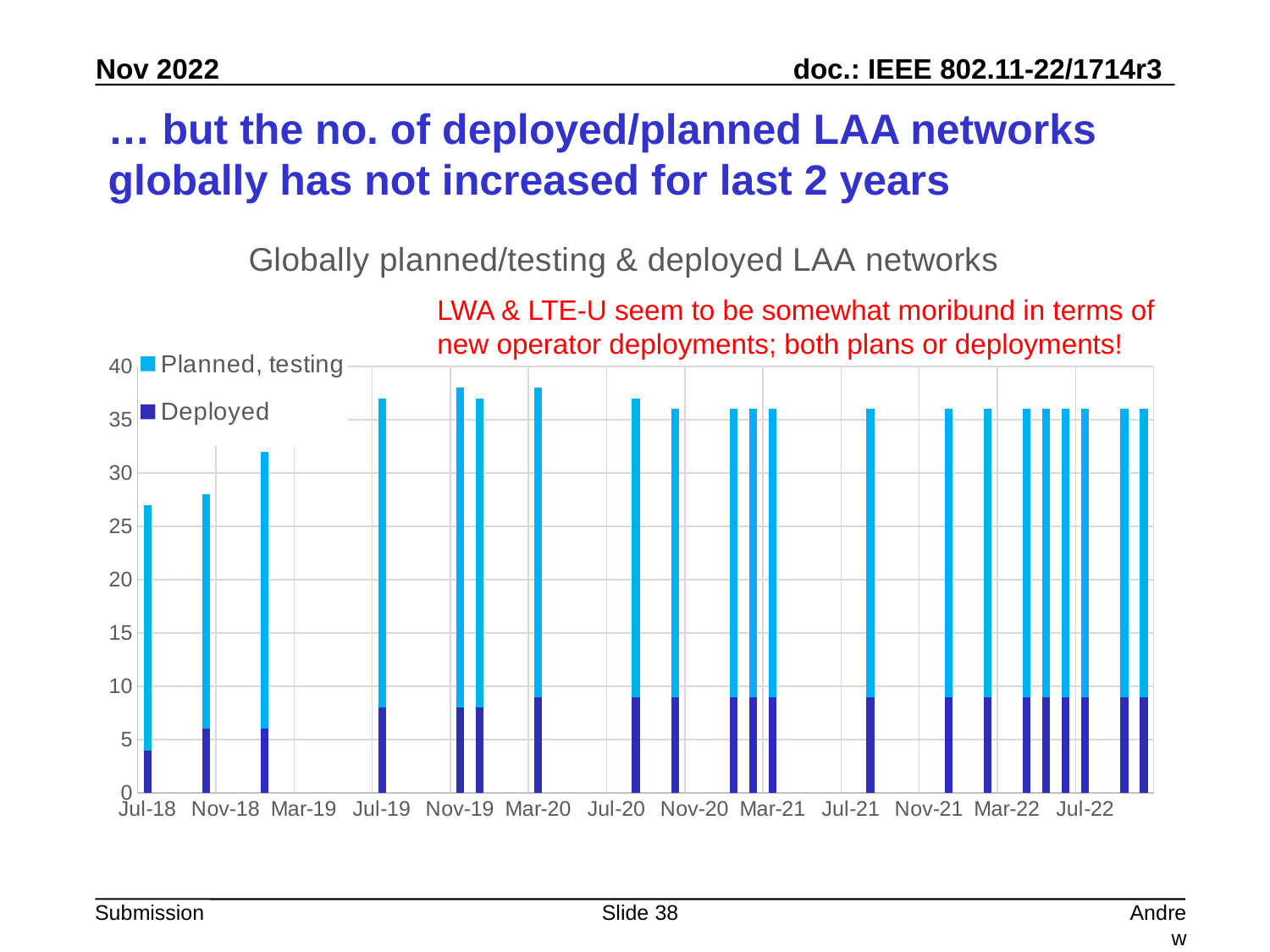
Is the total height of the Jul-19 bar greater or less than 35? greater What kind of chart is shown on the slide? Stacked bar chart Which has the larger Deployed value, Jul-18 or Jul-22? Jul-22 Is the Deployed value for Jul-18 greater or less than 5? less Is the total height of the Jul-18 bar greater or less than 30? less What is the title of the chart? Globally planned/testing & deployed LAA networks Which has the larger total bar height, Jul-18 or Jul-19? Jul-19 Do the total bar heights rise or fall from Jul-18 to Jul-19? rise What are the two series named in the chart legend? Planned, testing; Deployed How many series does the chart legend list? 2